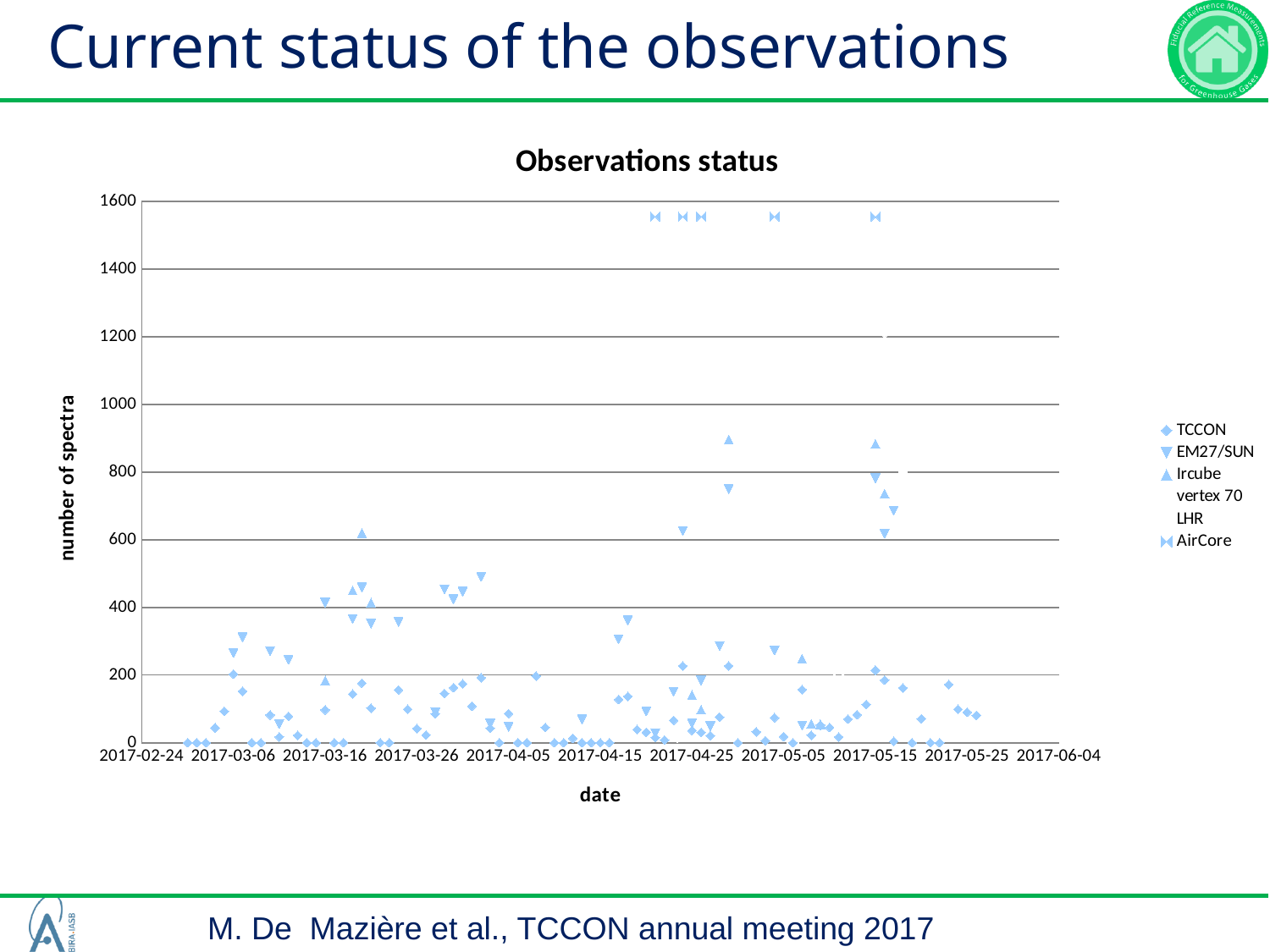
How many date labels are shown along the x axis? 11 What is the label of the vertical axis? number of spectra Is the highest EM27/SUN point greater or less than 600? greater What kind of chart is shown on the slide? scatter chart How many series does the legend list? 6 Is the highest TCCON point greater or less than 400? less Which series has the highest plotted values on the chart? AirCore How many AirCore points are plotted on the chart? 5 What is the title of the chart? Observations status Is the highest Ircube point greater or less than 1000? less